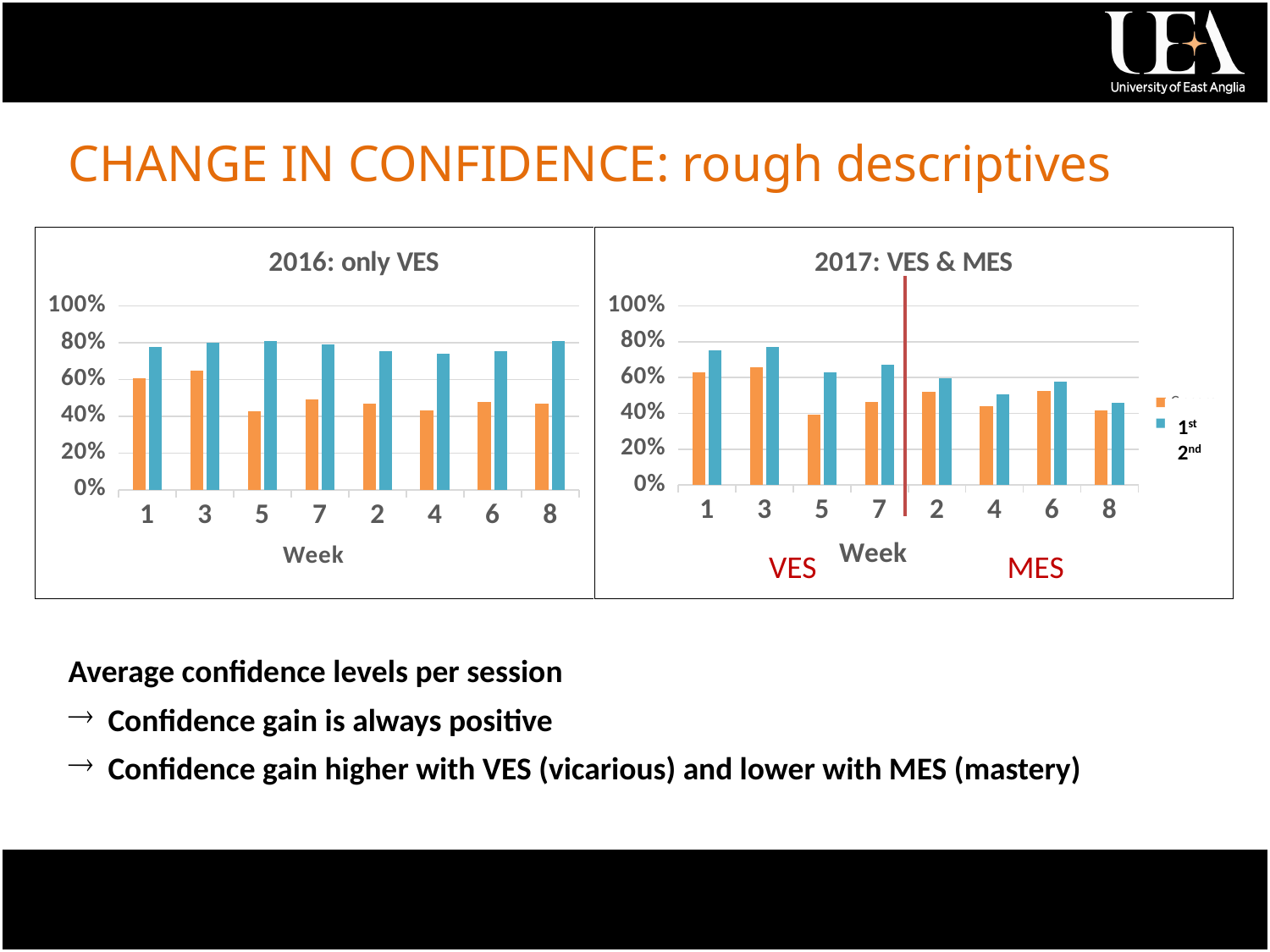
How many week categories are shown on the x axis of the '2017: VES & MES' chart? 8 What kind of chart is the '2016: only VES' chart? bar chart In the '2017: VES & MES' chart, is the blue (2nd) bar for week 3 greater or less than 60%? greater In the '2016: only VES' chart, is the orange (1st) bar for week 5 greater or less than 60%? less In the '2017: VES & MES' chart, is the orange (1st) bar for week 5 greater or less than 60%? less What is the x-axis label of the '2017: VES & MES' chart? Week In the '2017: VES & MES' chart, which bar is larger for week 5: the orange (1st) bar or the blue (2nd) bar? the blue (2nd) bar How many series does the legend of the '2017: VES & MES' chart list? 2 In the '2016: only VES' chart, which bar is larger for week 7: the orange (1st) bar or the blue (2nd) bar? the blue (2nd) bar What is the title of the chart on the left of the slide? 2016: only VES